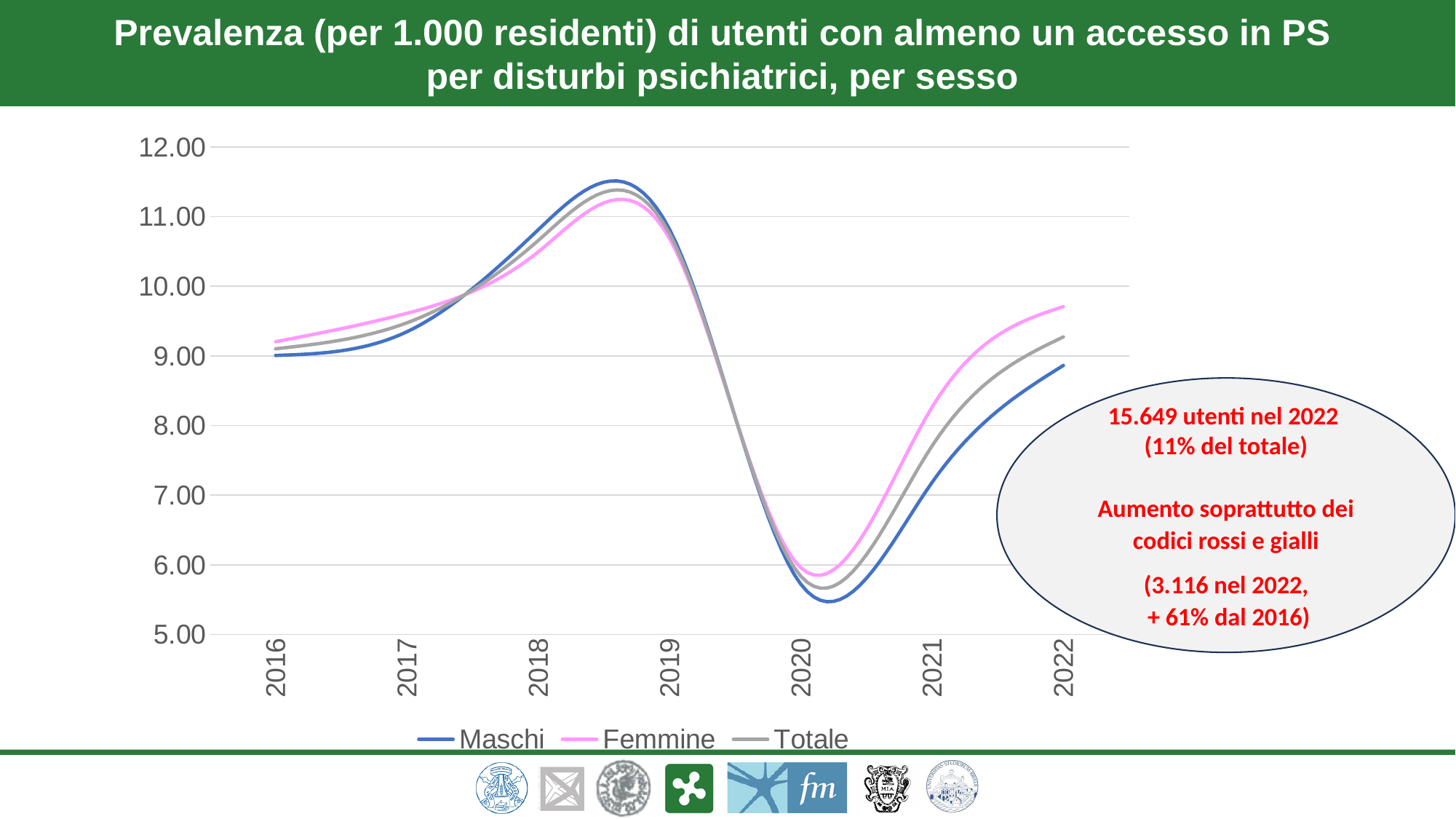
Is the value for Femmine in 2022 greater or less than 9.00? greater Is the value for Maschi in 2018 greater or less than 11.00? less What kind of chart is shown on the slide? line chart In 2018, which series has the higher value, Maschi or Femmine? Maschi Do the values of the Totale series rise or fall from 2018 to 2020? fall Which colour is used for the Femmine series? pink How many years are shown on the x axis? 7 In 2022, which series has the higher value, Maschi or Femmine? Femmine In which year does the Femmine series reach its lowest value? 2020 How many series does the legend list? 3 Is the value for Maschi in 2020 greater or less than 6.00? less